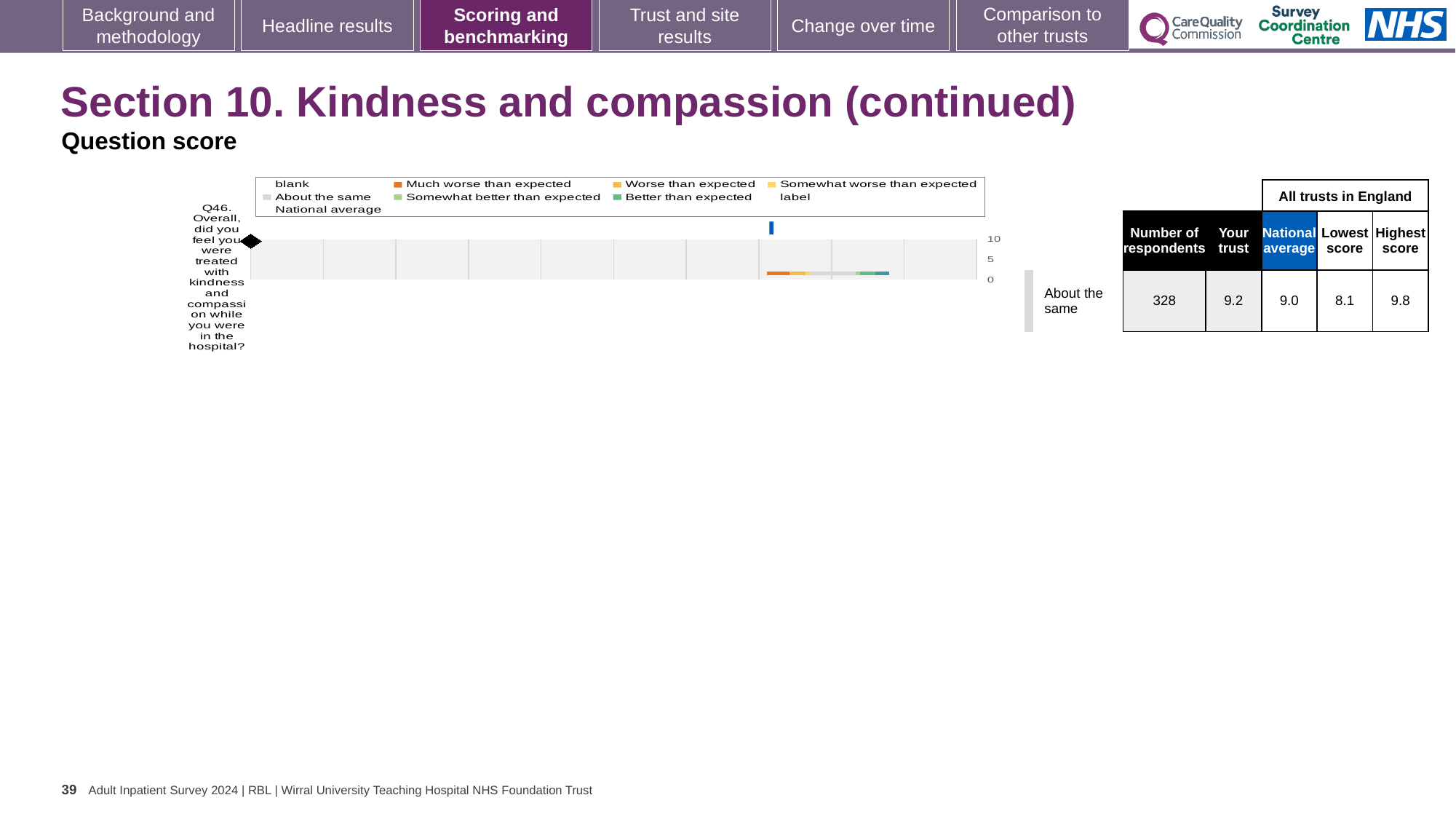
Which legend entry is shown in orange on the Q46 chart? Much worse than expected What is the lowest score among all trusts in England for Q46? 8.1 What benchmark category is the trust's Q46 score placed in? About the same What is the difference between the highest and lowest scores among all trusts in England for Q46? 1.7 What is the highest score among all trusts in England for Q46? 9.8 What is the 'Your trust' score for Q46? 9.2 How many respondents answered Q46? 328 Which is larger for Q46, the 'Your trust' score or the national average? Your trust What kind of chart is used to show the Q46 question score? bar chart What is the difference between the 'Your trust' score and the national average for Q46? 0.2 What is the national average score for Q46? 9.0